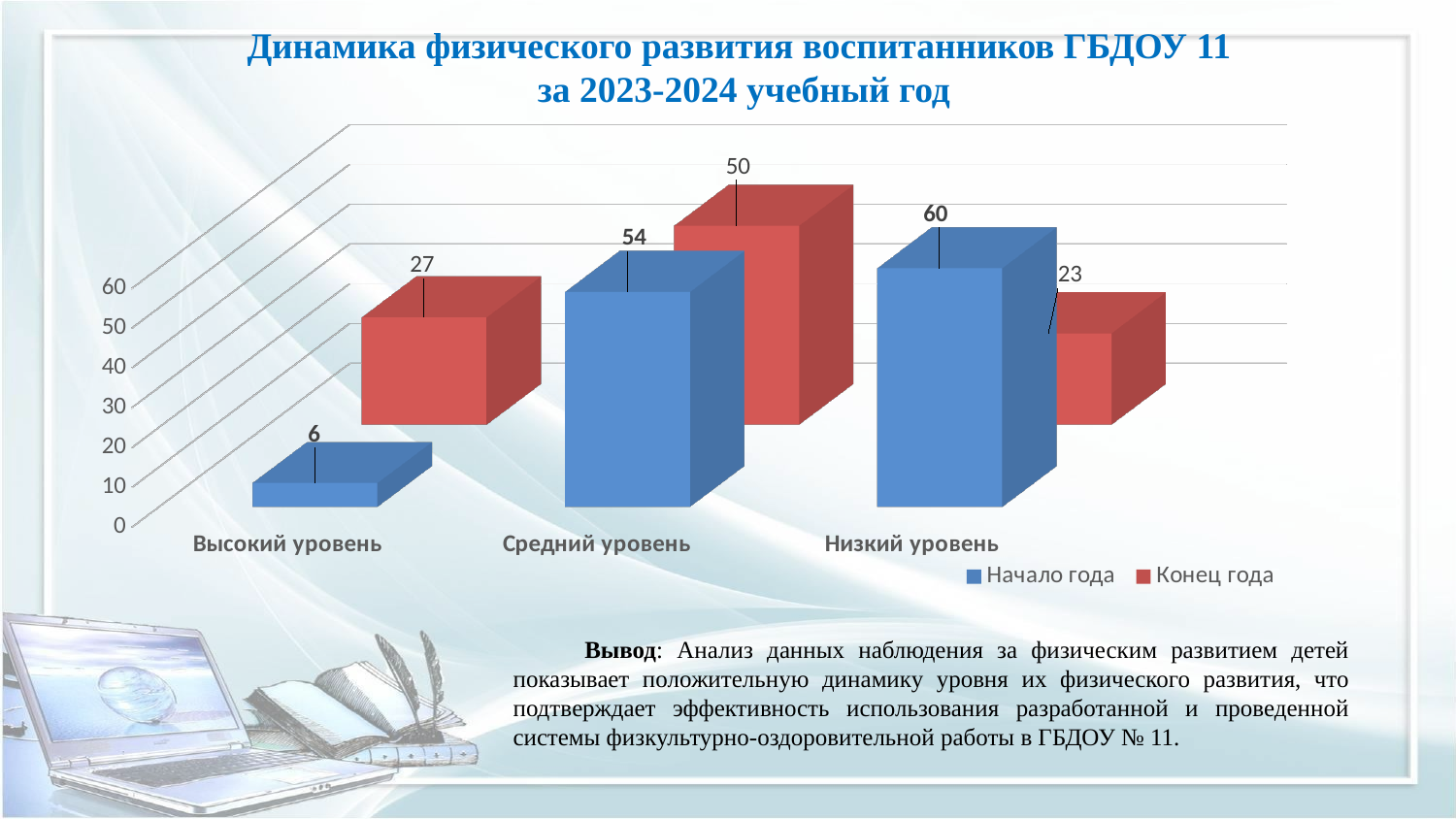
How many series does the legend list? 2 What kind of chart is shown on the slide? Bar chart How many categories are shown on the x axis? 3 What is the value for Начало года in the Низкий уровень category? 60 What is the value for Начало года in the Высокий уровень category? 6 Which category has the highest value for the Начало года series? Низкий уровень What colour represents the Конец года series? Red What is the value for Конец года in the Низкий уровень category? 23 Which category has the lowest value for the Конец года series? Низкий уровень Which is larger in the Средний уровень category: Начало года or Конец года? Начало года What is the value for Конец года in the Высокий уровень category? 27 What is the difference between the Начало года and Конец года values for Низкий уровень? 37